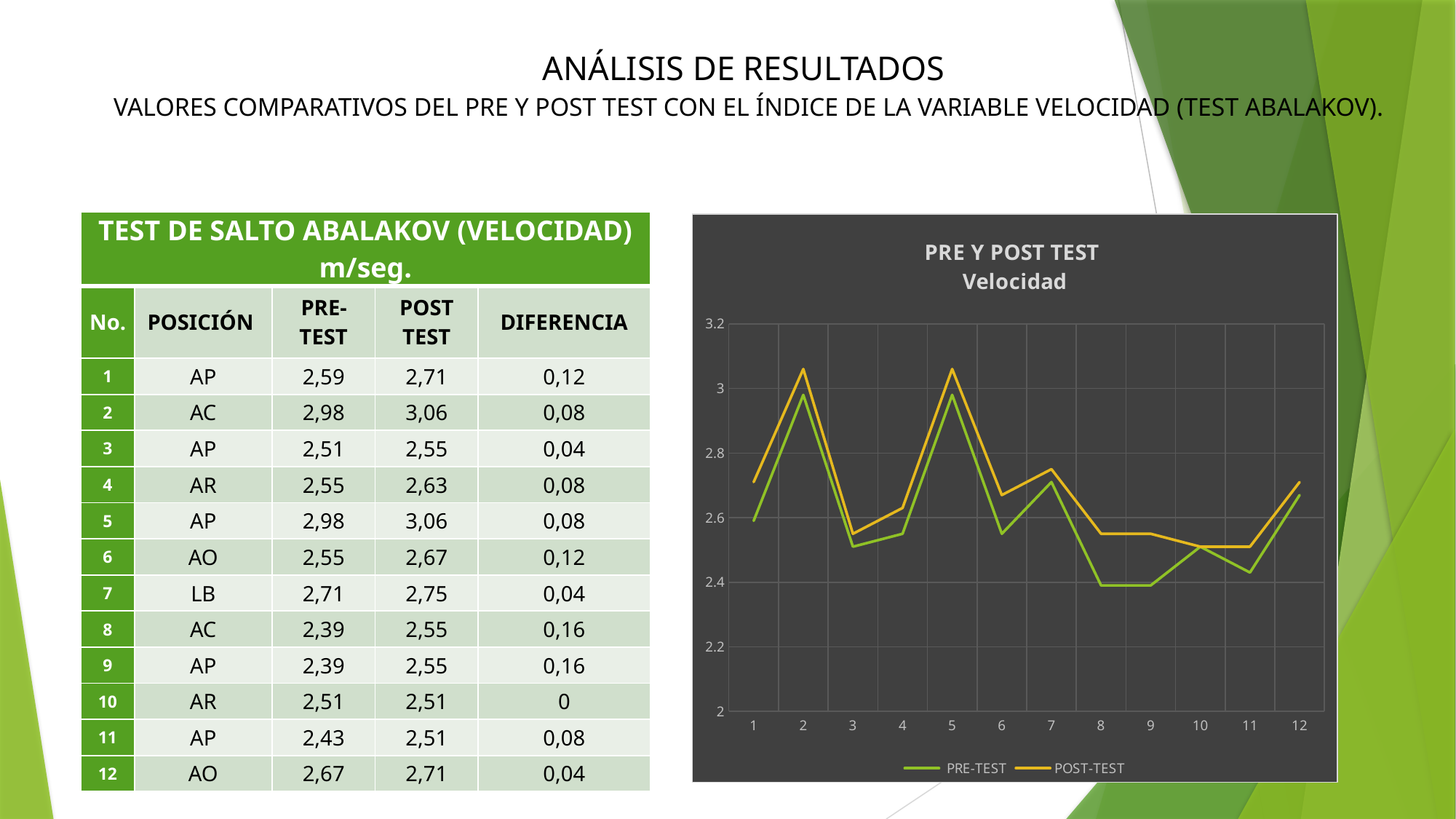
At point 11, which line is higher, PRE-TEST or POST-TEST? POST-TEST What is the POST-TEST value at point 5, as given in the table on the slide? 3,06 How many points are plotted along the x axis of the chart? 12 What kind of chart is shown on the slide? line chart Is the POST-TEST value at point 2 greater or less than 3? greater Which colour is used for the POST-TEST line in the chart? orange How many series does the legend of the chart list? 2 Is the PRE-TEST value at point 1 greater or less than 2.8? less Is the PRE-TEST value at point 8 greater or less than 2.6? less What is the difference between the POST-TEST and PRE-TEST values at point 8, as given in the table? 0,16 What is the title of the chart? PRE Y POST TEST Velocidad Does the PRE-TEST line rise or fall from point 7 to point 8? fall